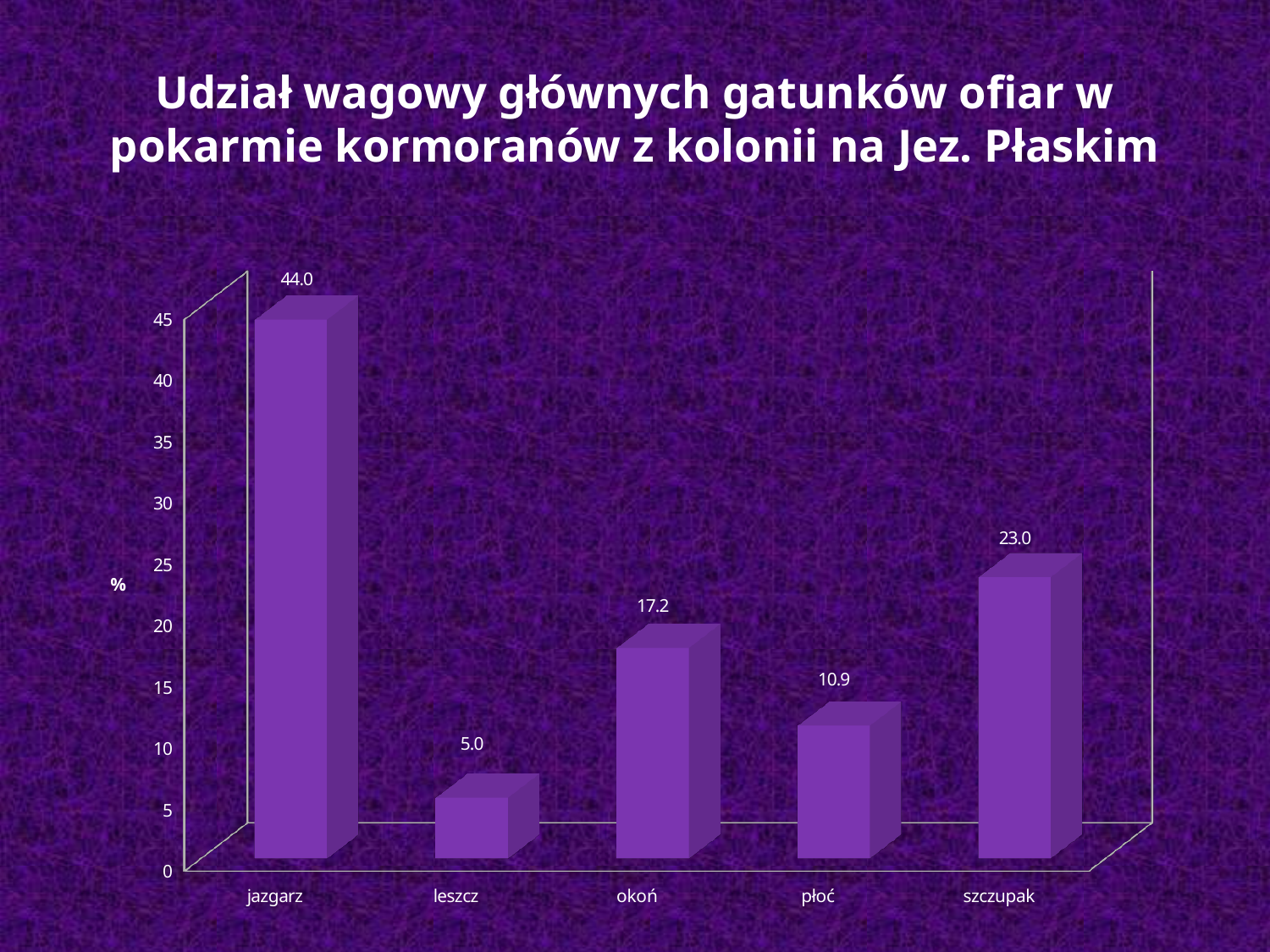
Which category has the highest value? jazgarz What is the value for leszcz? 5.0 What is the value for szczupak? 23.0 What is the value for płoć? 10.9 What is the difference between the values for jazgarz and szczupak? 21.0 What is the label on the vertical axis? % Which is larger, the value for okoń or the value for płoć? okoń What kind of chart is shown on the slide? bar chart What is the value for okoń? 17.2 What is the value for jazgarz? 44.0 How many categories are shown on the x axis? 5 Which category has the lowest value? leszcz